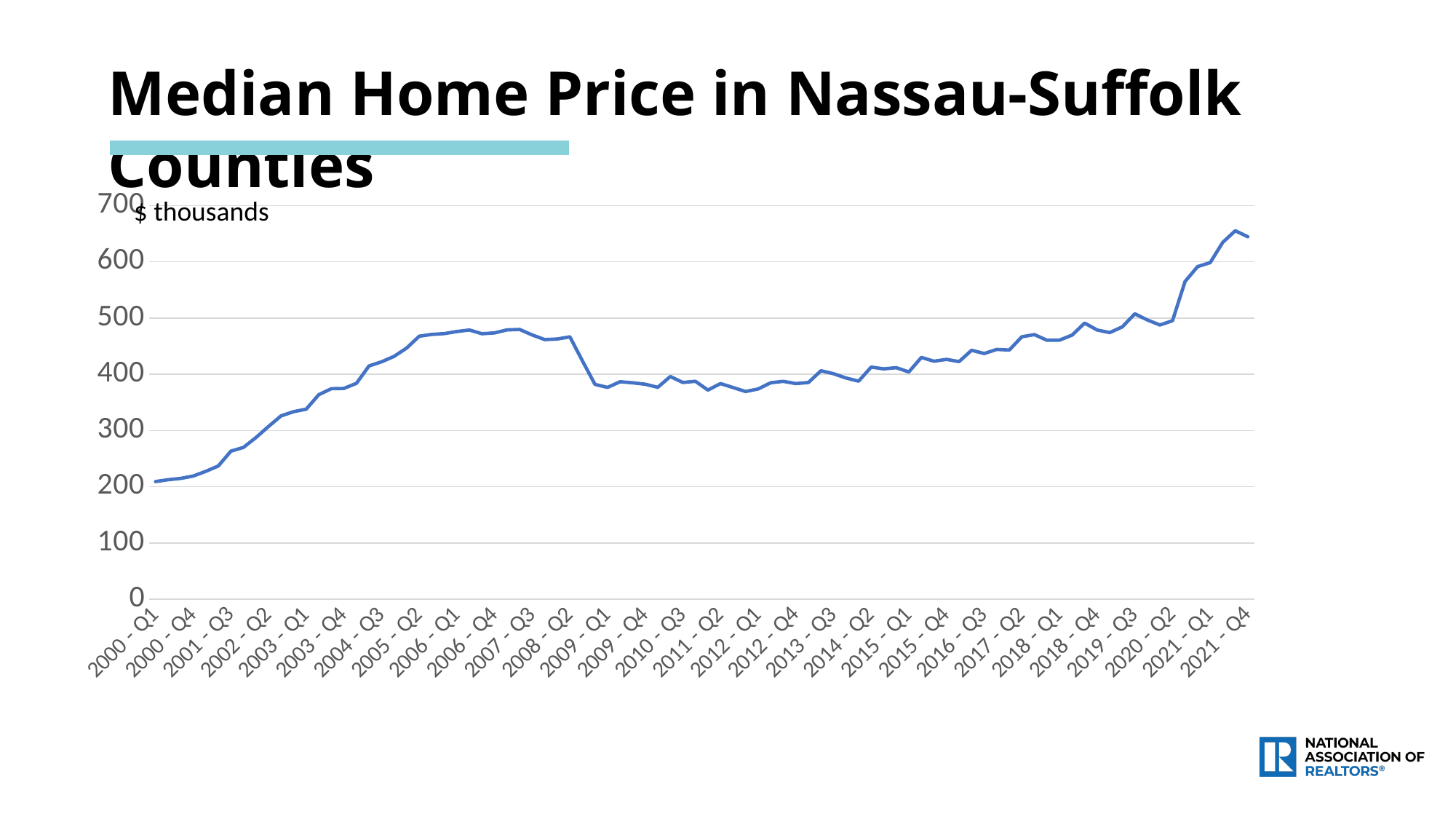
Which quarter has the lowest median home price on the chart? 2000 - Q1 Is the median home price for 2000 - Q1 greater or less than 300? less Is the median home price for 2016 - Q3 greater or less than 400? greater In what units are the values on the vertical axis expressed? $ thousands What kind of chart is shown on the slide? line chart Is the median home price for 2021 - Q4 greater or less than 600? greater What is the title of the chart? Median Home Price in Nassau-Suffolk Counties Does the median home price rise or fall between 2008 - Q2 and 2009 - Q1? fall Which is larger, the median home price in 2006 - Q4 or in 2012 - Q1? 2006 - Q4